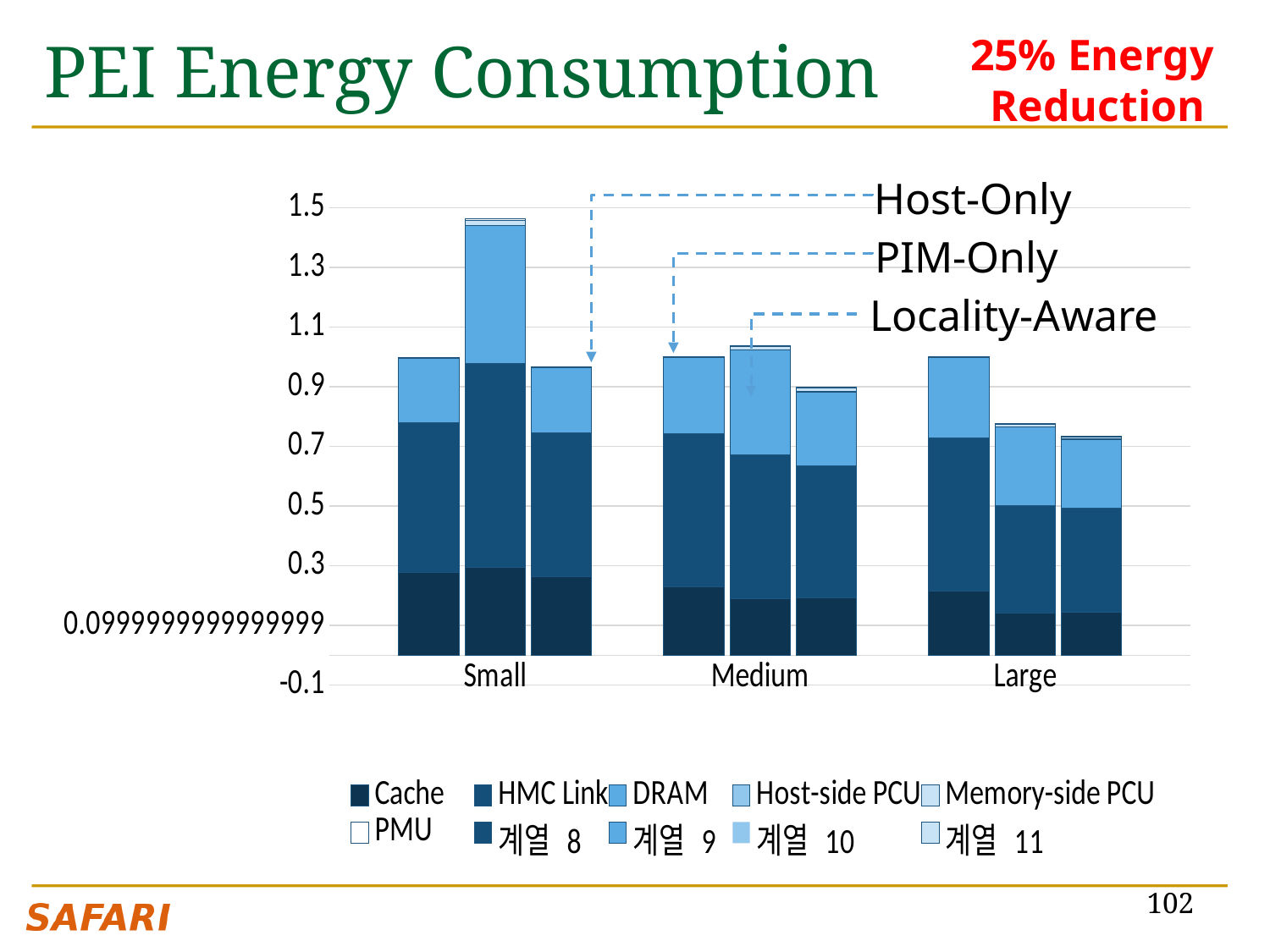
How many categories are shown on the x axis of the chart? 3 Do the Locality-Aware bars rise or fall from Small to Large? fall What energy reduction is stated in red at the top right of the slide? 25% Energy Reduction Which bar in the chart is the tallest overall? PIM-Only for Small How many entries does the chart's legend list? 10 Is the total height of the PIM-Only bar for Small greater or less than 1.3? greater What is the title of the slide containing the chart? PEI Energy Consumption For the Small category, which bar is taller: PIM-Only or Locality-Aware? PIM-Only Is the total height of the Locality-Aware bar for Large greater or less than 0.9? less Is the total height of the PIM-Only bar for Medium greater or less than 0.9? greater What kind of chart is shown on the slide? stacked bar chart